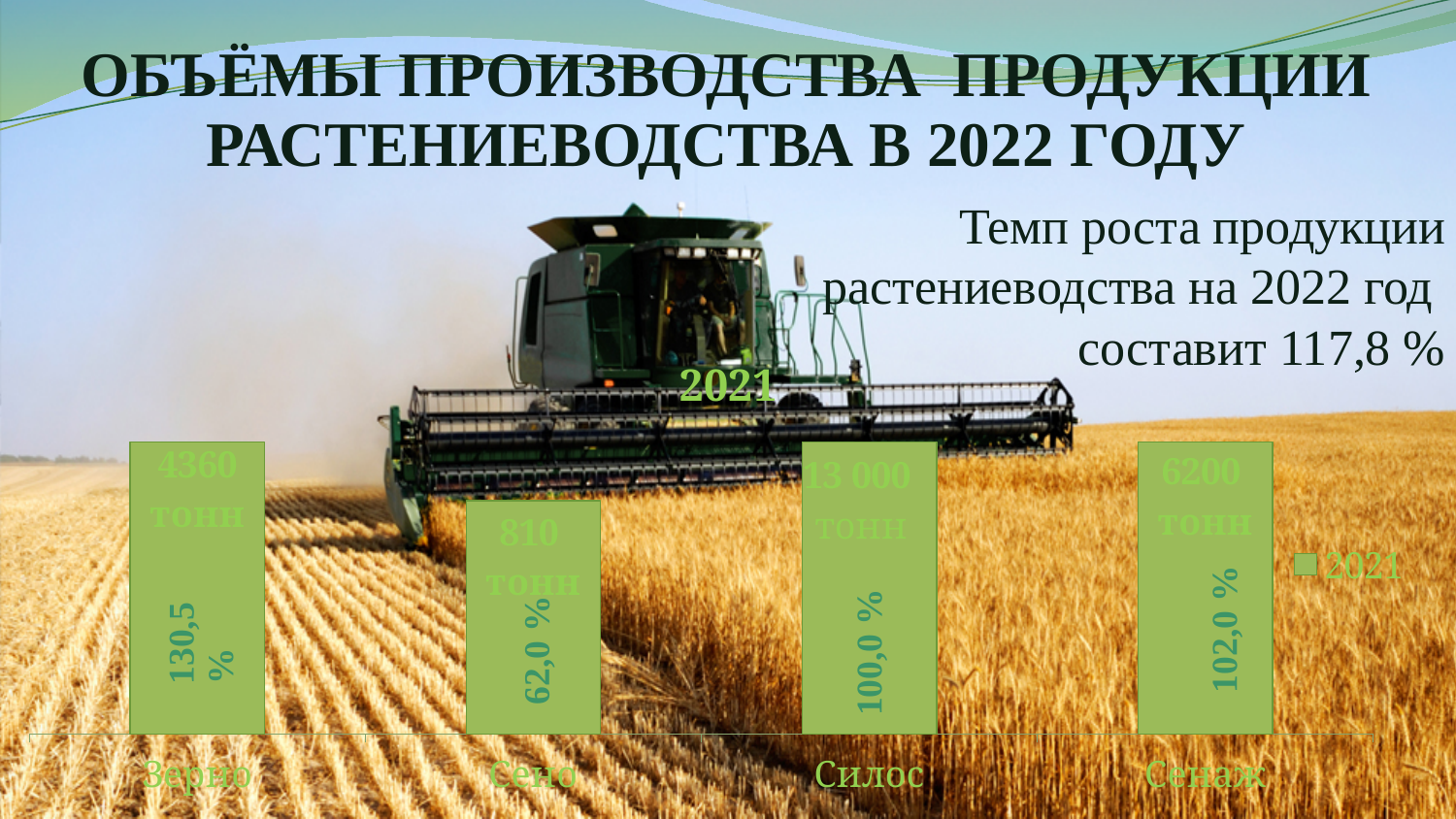
What percentage value is shown for Сено? 62,0 % Which category has the lowest percentage value? Сено What percentage value is shown for Сенаж? 102,0 % How many tonnes are shown for Силос? 13 000 тонн What is the title of the chart? 2021 What kind of chart is shown on the slide? bar chart What percentage value is shown for Зерно? 130,5 % What is the difference between the percentage values for Зерно and Сено? 68,5 % How many categories are shown on the x axis of the chart? 4 How many series does the chart legend list? 1 What percentage value is shown for Силос? 100,0 % Which category has the highest percentage value? Зерно